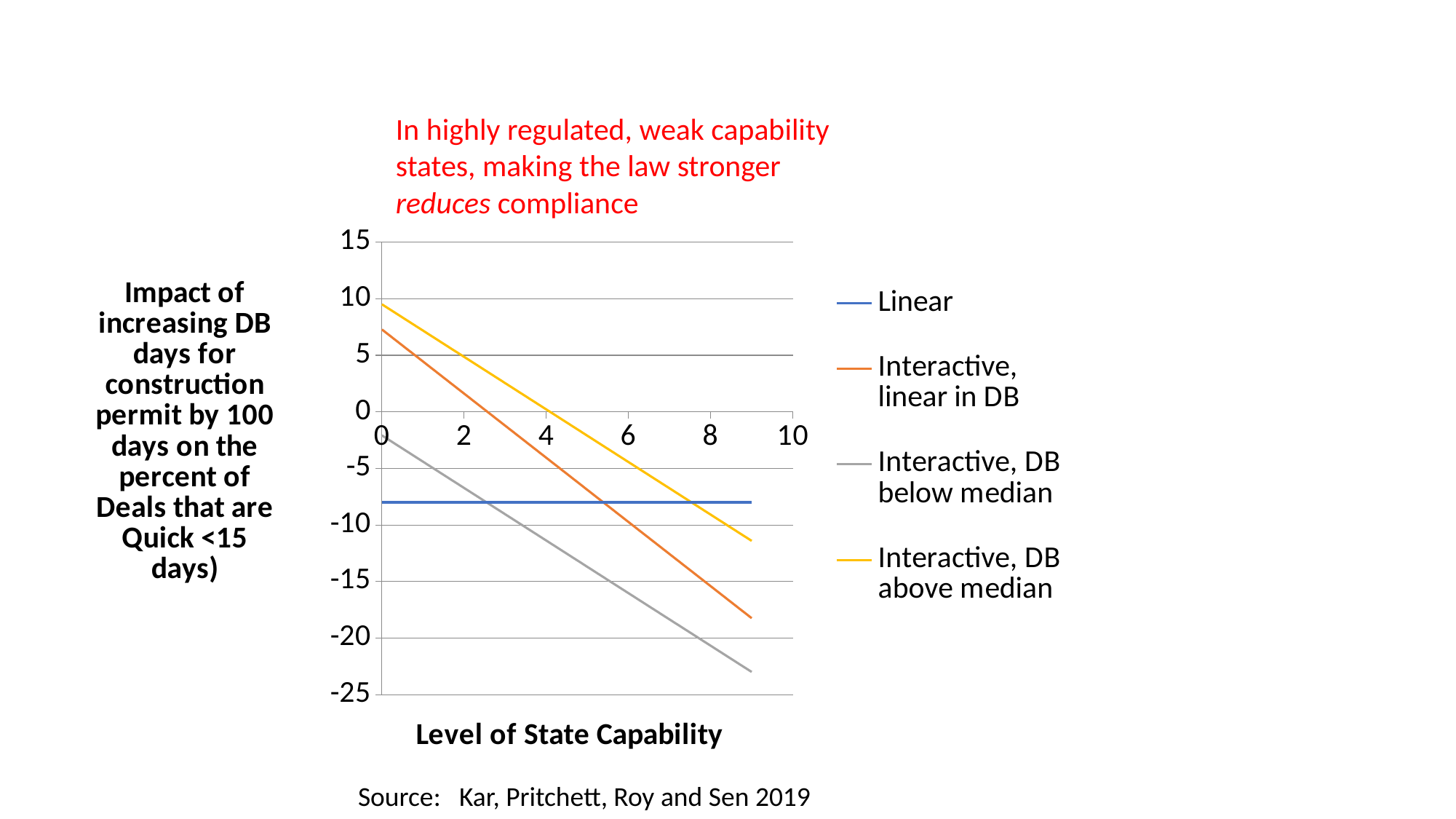
How many series does the legend list? 4 Does the 'Interactive, DB above median' line rise or fall as Level of State Capability increases? Fall Is the value of the 'Interactive, linear in DB' line at a Level of State Capability of 8 greater or less than -10? less Which legend entry is drawn in yellow? Interactive, DB above median What kind of chart is shown on the slide? Line chart What is the title of the x axis? Level of State Capability Does the 'Interactive, DB below median' line rise or fall as Level of State Capability increases? Fall Is the value of the 'Interactive, DB above median' line at a Level of State Capability of 0 greater or less than 5? greater Is the value of the 'Interactive, DB below median' line at a Level of State Capability of 0 greater or less than 0? less At a Level of State Capability of 8, which line is lower: 'Interactive, DB below median' or 'Linear'? Interactive, DB below median At a Level of State Capability of 0, which line is higher: 'Interactive, DB above median' or 'Interactive, DB below median'? Interactive, DB above median